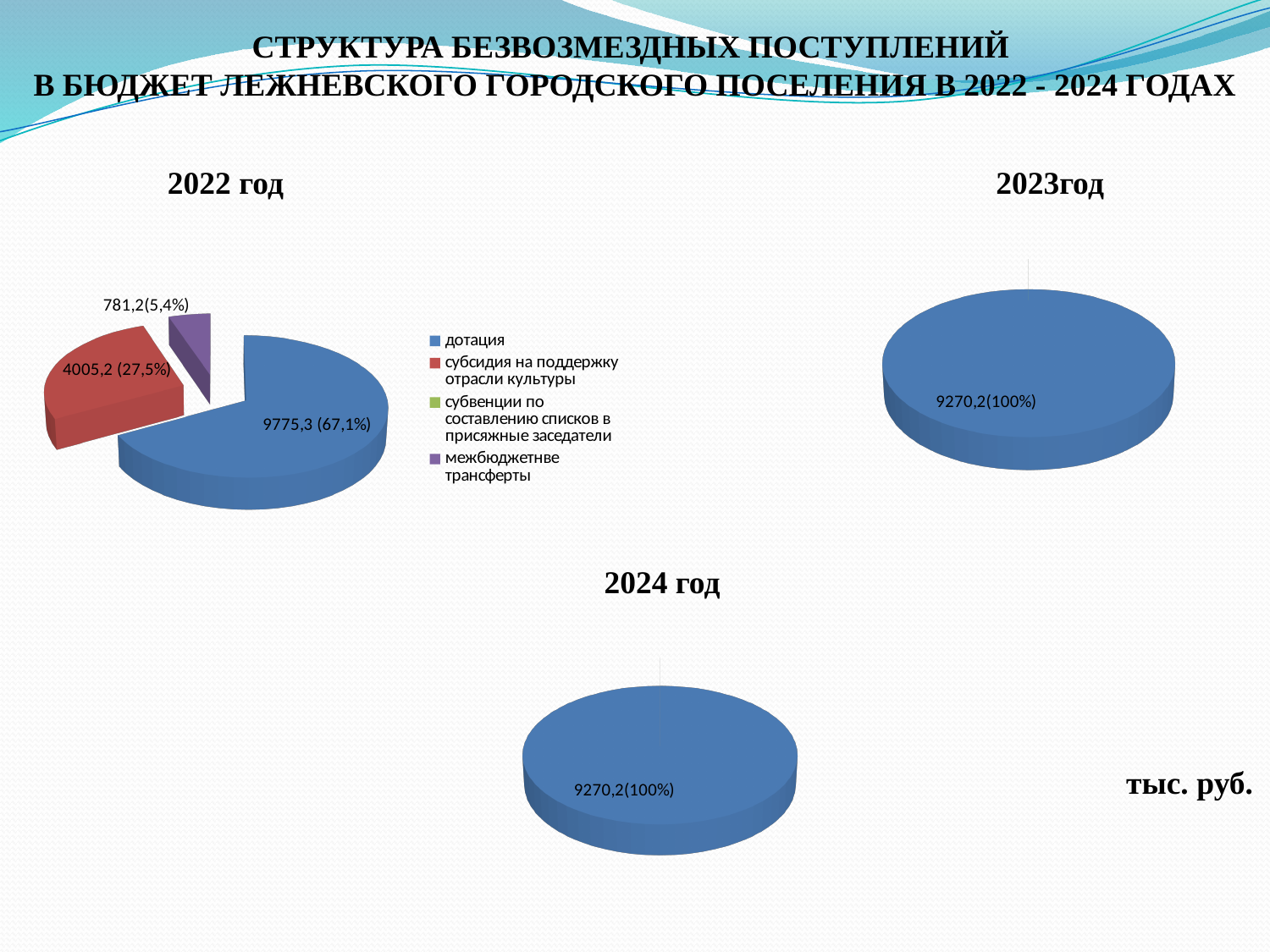
In the 2022 год pie chart, what share of the pie does субсидия на поддержку отрасли культуры take? 27,5% What is the value shown in the 2024 год pie chart? 9270,2(100%) In the 2022 год pie chart, what is the value shown for межбюджетные трансферты? 781,2(5,4%) In the 2022 год pie chart, which labelled category has the smallest slice? межбюджетные трансферты In the 2022 год pie chart, what is the value shown for субсидия на поддержку отрасли культуры? 4005,2 (27,5%) In the 2022 год pie chart, which is larger: дотация or субсидия на поддержку отрасли культуры? дотация In the 2022 год pie chart, what is the difference between the дотация value and the субсидия на поддержку отрасли культуры value? 5770,1 What is the value shown in the 2023год pie chart? 9270,2(100%) How many entries does the legend of the 2022 год chart list? 4 In the 2022 год pie chart, which category has the largest slice? дотация What kind of chart is used for the 2024 год data? pie chart In the 2022 год pie chart, what is the value shown for дотация? 9775,3 (67,1%)